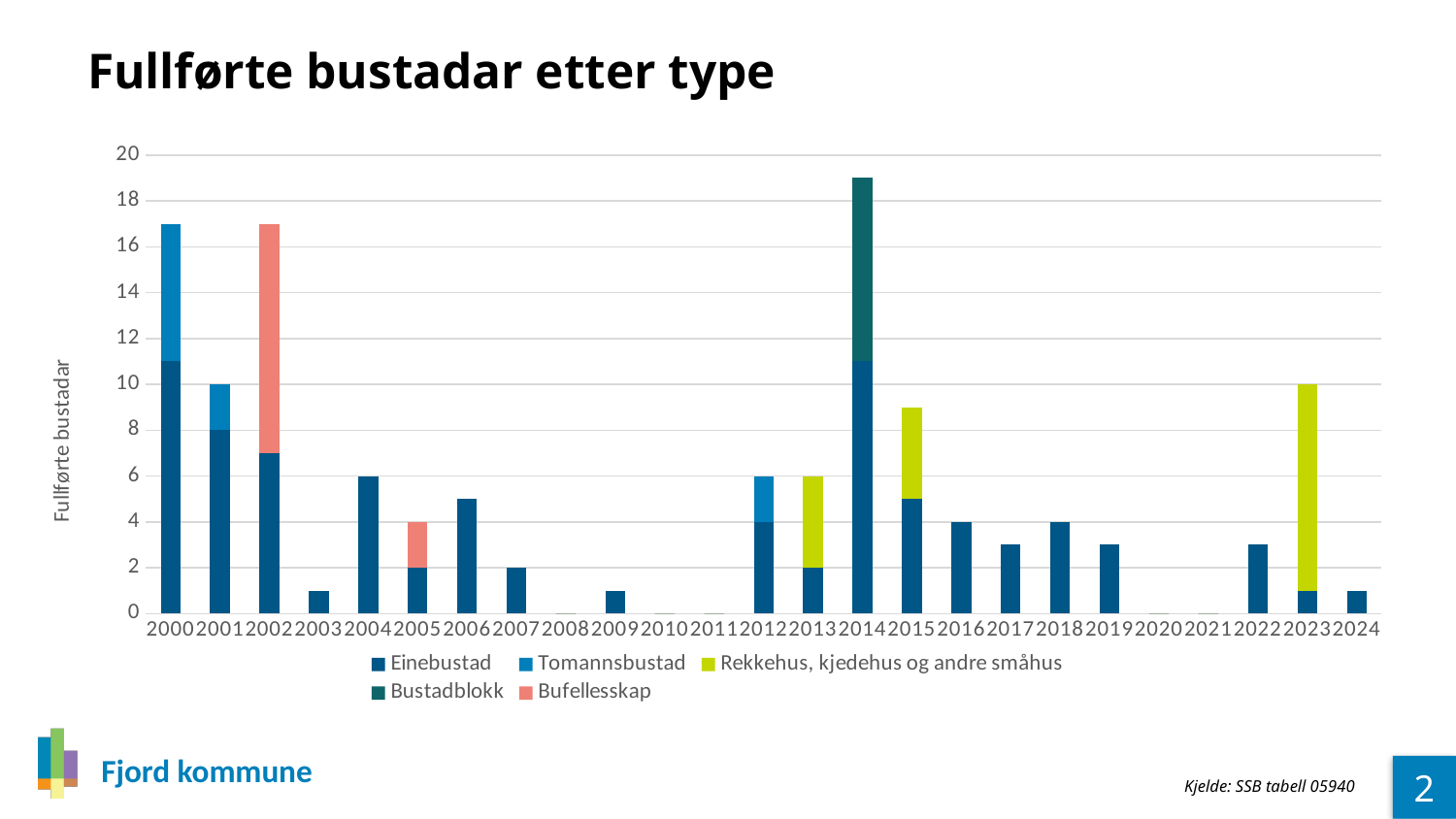
What is the total value of the bar for 2023? 10 How many series does the legend list? 5 What kind of chart is shown on the slide? Stacked bar chart How many years are shown along the x axis? 25 Is the total value for 2002 greater or less than 16? greater Is the total value for 2014 greater or less than 18? greater What is the value for Einebustad in 2004? 6 What is the total value of the bar for 2001? 10 Which series is shown in the light green colour in the legend? Rekkehus, kjedehus og andre småhus Which bar is taller in total, 2000 or 2015? 2000 Which year has the tallest bar in total? 2014 What is the value for Einebustad in 2016? 4